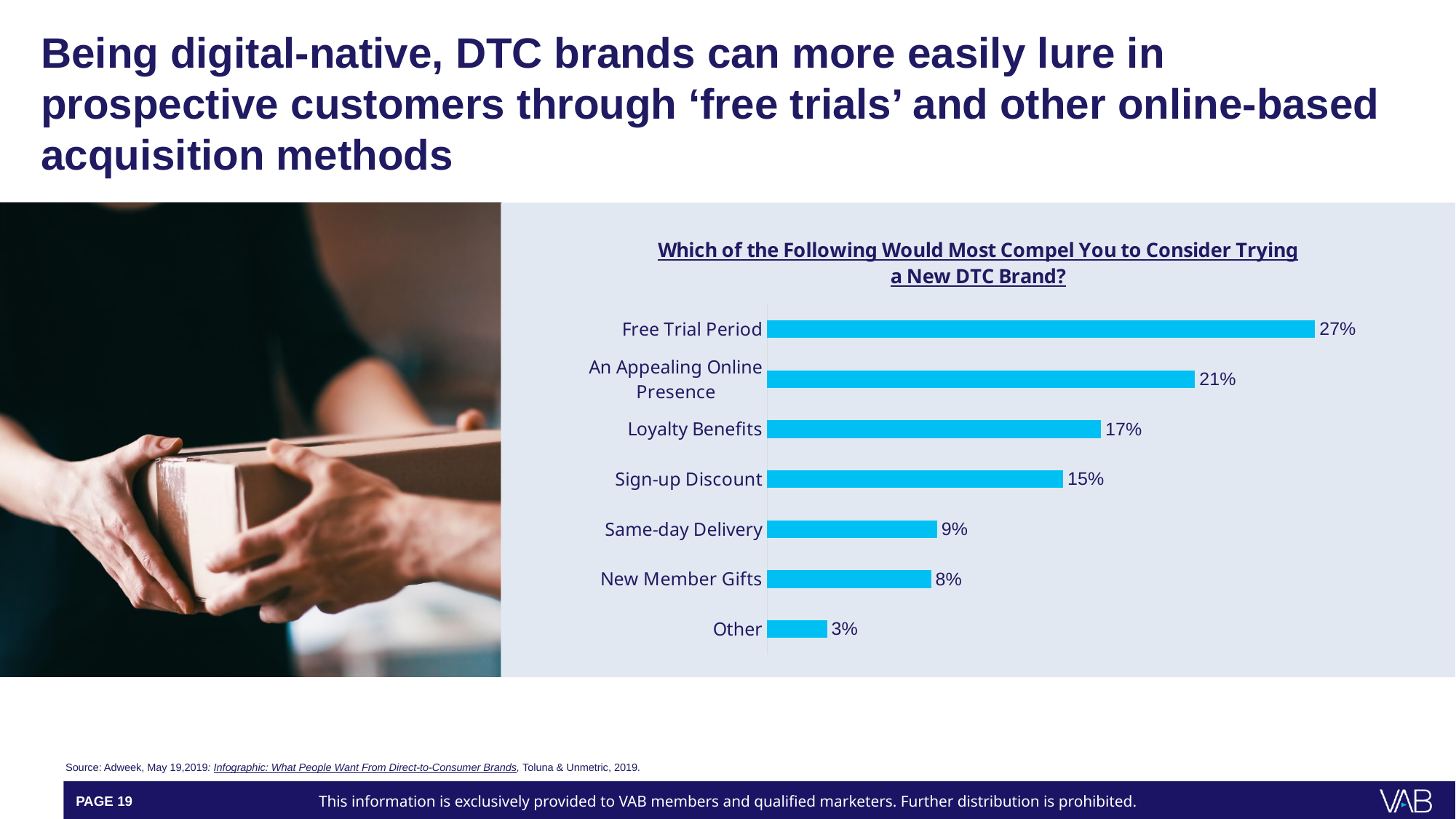
How many categories are shown in the chart? 7 What is the title of the chart? Which of the Following Would Most Compel You to Consider Trying a New DTC Brand? Which category has the lowest value in the chart? Other Which category has the highest value in the chart? Free Trial Period What is the value for Loyalty Benefits? 17% What colour are the bars in the chart? Light blue Which is larger, the value for Loyalty Benefits or the value for Sign-up Discount? Loyalty Benefits What is the difference between the values for Sign-up Discount and New Member Gifts? 7% What kind of chart is shown on the slide? Bar chart What is the difference between the values for Free Trial Period and An Appealing Online Presence? 6% What percentage of respondents chose Free Trial Period as what would most compel them to try a new DTC brand? 27% What is the value for Same-day Delivery? 9%